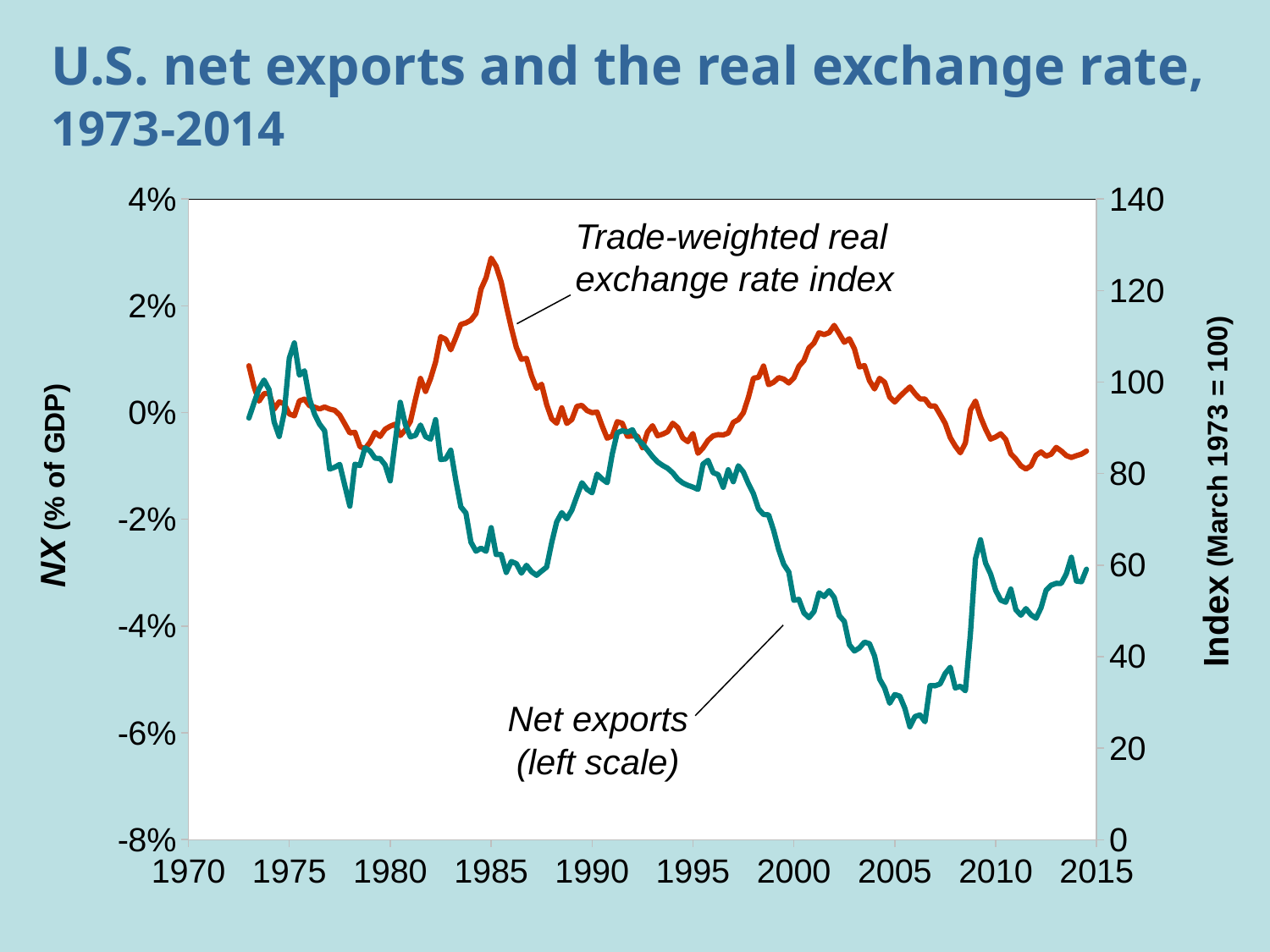
How many data series are plotted on the chart? 2 Is the value of the trade-weighted real exchange rate index around 2002 greater or less than 100? greater Is the value of the trade-weighted real exchange rate index in 2014 greater or less than 100? less Does the trade-weighted real exchange rate index rise or fall between 1995 and 2002? rise Does the trade-weighted real exchange rate index rise or fall between 1985 and 1988? fall Is the value of net exports around 2000 greater or less than -2%? less What kind of chart is shown on the slide? line chart What is the title of the chart? U.S. net exports and the real exchange rate, 1973-2014 Which series is plotted against the left scale? Net exports Do net exports rise or fall between 1997 and 2006? fall